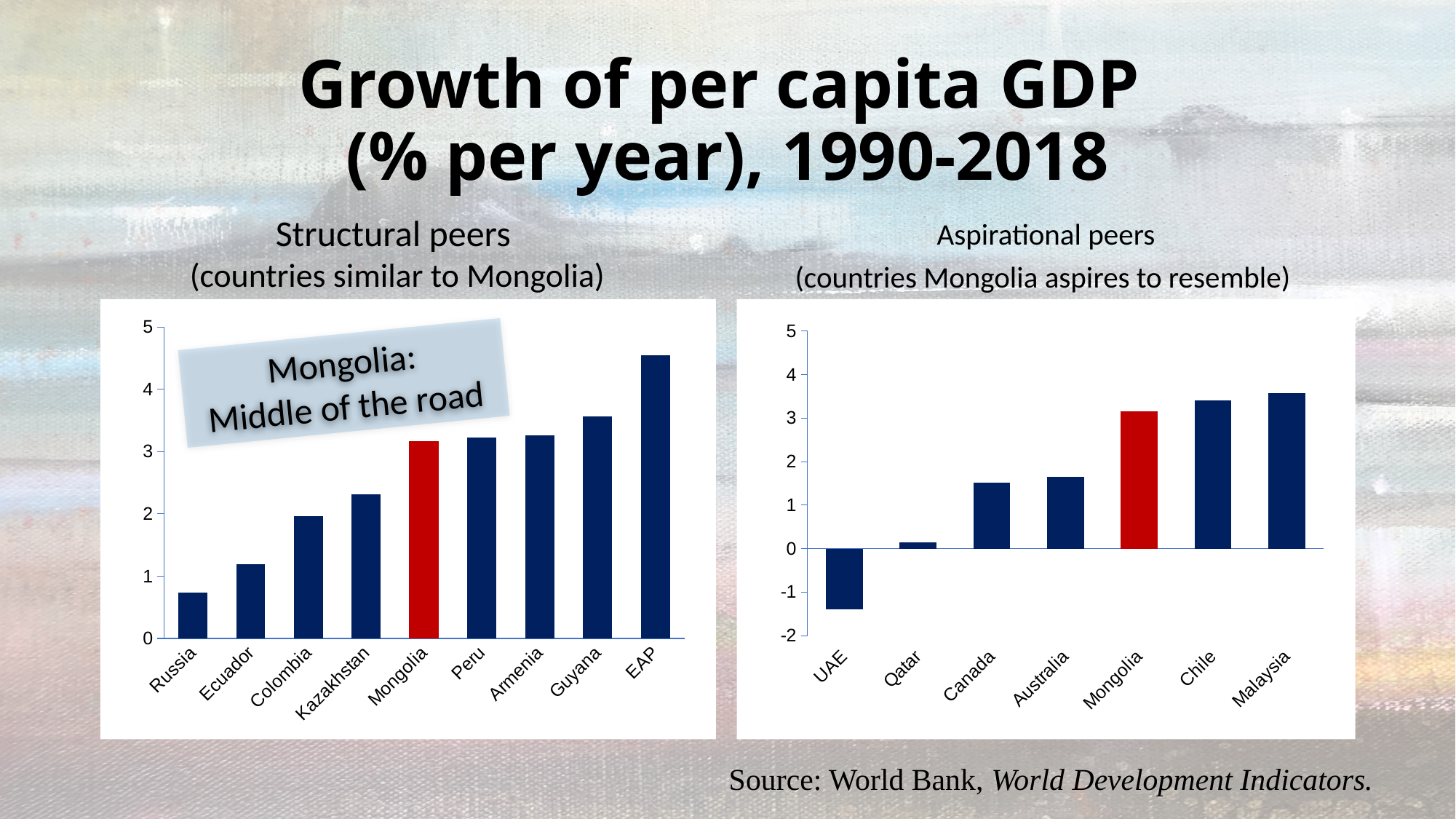
In the Aspirational peers chart on the right, which country has the lowest growth? UAE In the Structural peers chart on the left, is the value for Kazakhstan greater or less than 2? greater In the Structural peers chart on the left, which country has the lowest growth? Russia In the Aspirational peers chart on the right, is the value for UAE greater or less than -1? less In the Structural peers chart on the left, which category has the highest growth? EAP In the Structural peers chart on the left, is the value for Russia greater or less than 1? less In the Aspirational peers chart on the right, which has the larger value, Canada or Mongolia? Mongolia How many countries or groups are shown in the Structural peers chart on the left? 9 How many countries are shown in the Aspirational peers chart on the right? 7 What kind of chart is the Structural peers chart on the left? bar chart In the Structural peers chart on the left, which country's bar is coloured red? Mongolia In the Structural peers chart on the left, do the values rise or fall from left to right along the x axis? rise